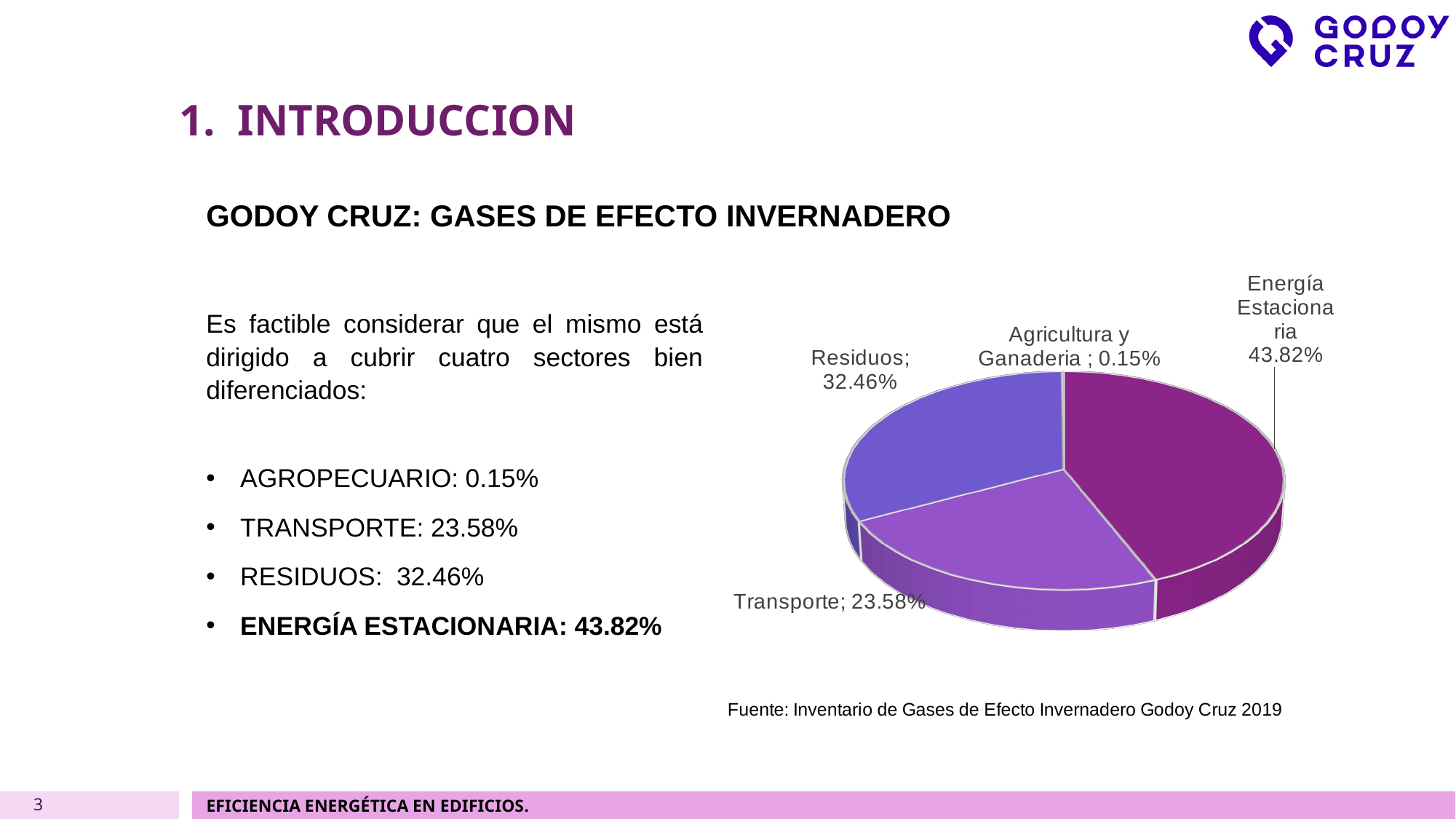
What source is cited below the pie chart? Inventario de Gases de Efecto Invernadero Godoy Cruz 2019 Which category has the largest slice of the pie? Energía Estacionaria Which is larger, the slice for Residuos or the slice for Transporte? Residuos What share of the pie does Energía Estacionaria represent? 43.82% What is the value shown for Transporte in the pie chart? 23.58% How many categories are shown in the pie chart? 4 What is the difference in percentage points between Energía Estacionaria and Residuos? 11.36 What kind of chart is shown on the slide? Pie chart What is the difference in percentage points between Residuos and Transporte? 8.88 What is the value shown for Agricultura y Ganaderia in the pie chart? 0.15% Which category has the smallest slice of the pie? Agricultura y Ganaderia What is the value shown for Residuos in the pie chart? 32.46%